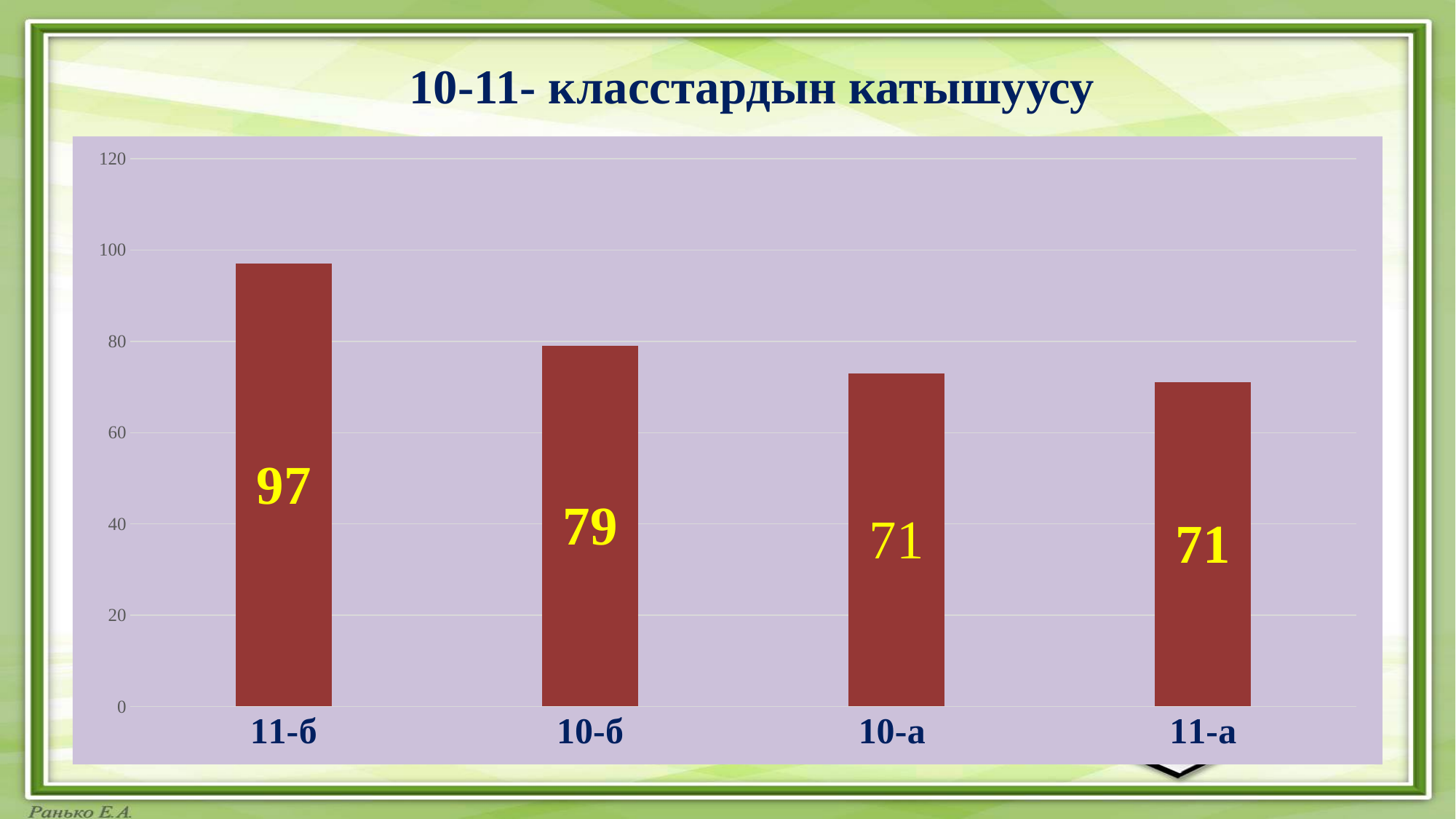
What is the difference between the values for 11-б and 10-б? 18 What is the title of the slide? 10-11- класстардын катышуусу What is the value for 11-а? 71 How many classes are shown on the chart? 4 What kind of chart is shown on the slide? bar chart Which class has the highest value? 11-б What is the value for 10-а? 71 What is the value for 11-б? 97 What is the value for 10-б? 79 What is the difference between the values for 10-б and 11-а? 8 Is the value for 11-б greater or less than 80? greater Which is larger, the value for 10-б or the value for 10-а? 10-б